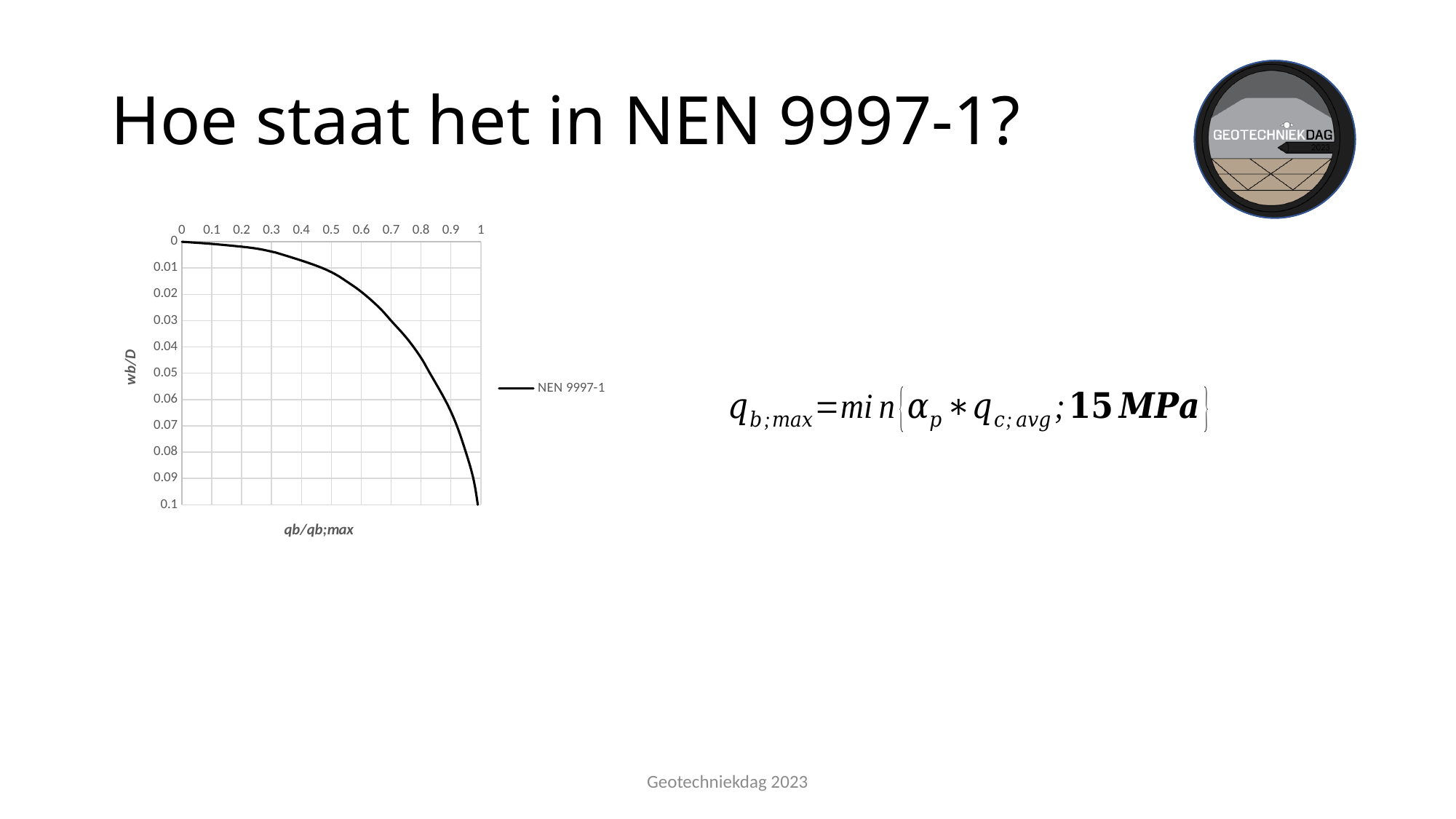
What is the name of the series shown in the chart legend? NEN 9997-1 Does the wb/D value of the NEN 9997-1 curve rise or fall as qb/qb;max increases from 0 to 1? rise What is the label of the horizontal axis of the chart? qb/qb;max What is the value of wb/D for the NEN 9997-1 curve at qb/qb;max = 0? 0 At which qb/qb;max value does the NEN 9997-1 curve reach its highest wb/D value? 1 Is the wb/D value of the NEN 9997-1 curve at qb/qb;max = 0.5 greater or less than 0.02? less Is the wb/D value of the NEN 9997-1 curve at qb/qb;max = 0.9 greater or less than 0.05? greater What is the value of wb/D where the NEN 9997-1 curve reaches qb/qb;max = 1? 0.1 How many series does the chart legend list? 1 Is the wb/D value of the NEN 9997-1 curve at qb/qb;max = 0.3 greater or less than 0.01? less What kind of chart is shown on the slide? line chart